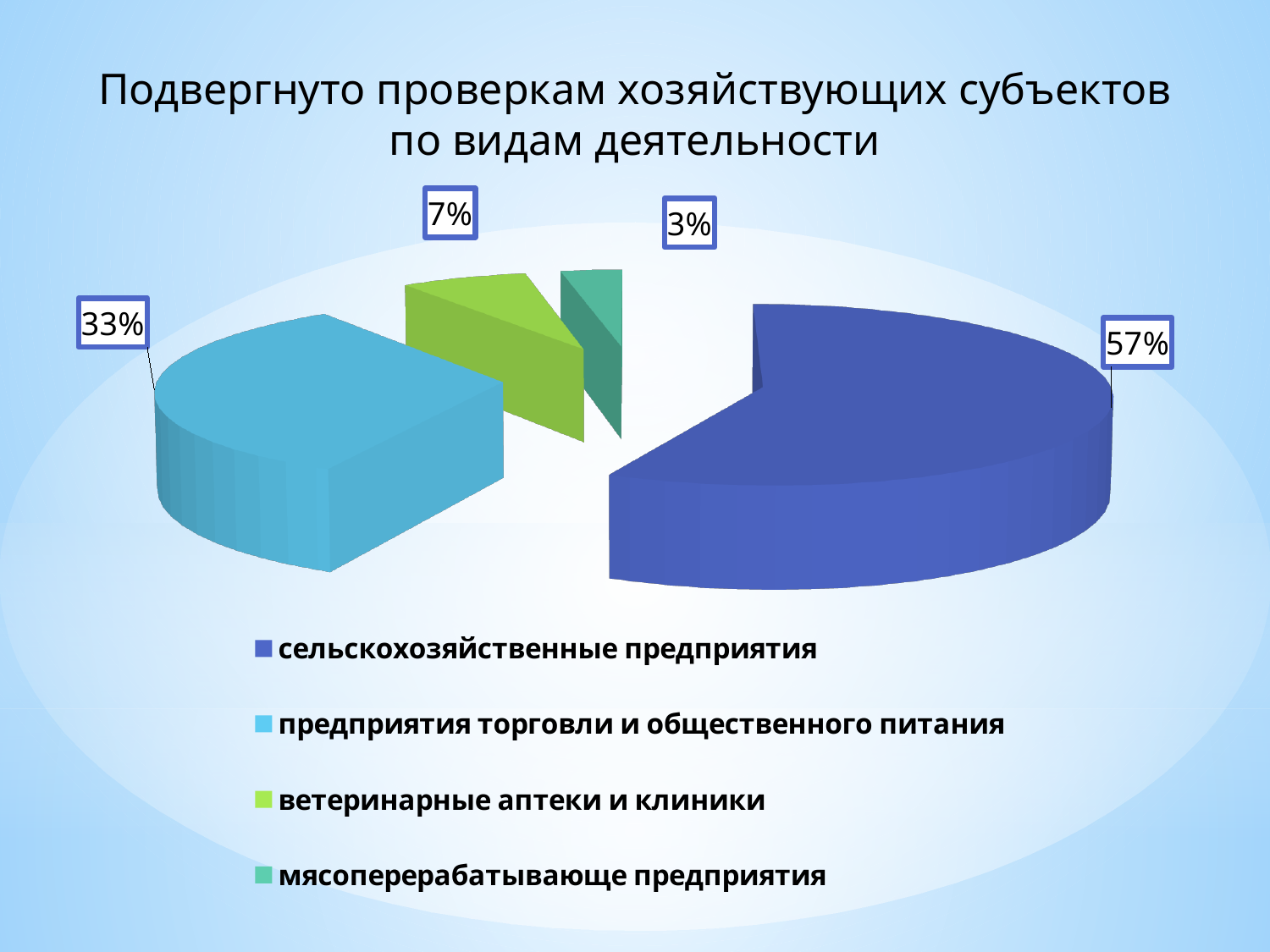
What is the difference between the shares of сельскохозяйственные предприятия and предприятия торговли и общественного питания? 24% What kind of chart is shown on the slide? pie chart Which category has the smallest slice of the pie? мясоперерабатывающе предприятия How many categories does the pie chart show? 4 What share of the pie is предприятия торговли и общественного питания? 33% What share of the pie is сельскохозяйственные предприятия? 57% What is the title of the chart? Подвергнуто проверкам хозяйствующих субъектов по видам деятельности What share of the pie is ветеринарные аптеки и клиники? 7% What colour is the slice for предприятия торговли и общественного питания? light blue Which category has the largest slice of the pie? сельскохозяйственные предприятия Which is larger: the share of ветеринарные аптеки и клиники or the share of мясоперерабатывающе предприятия? ветеринарные аптеки и клиники